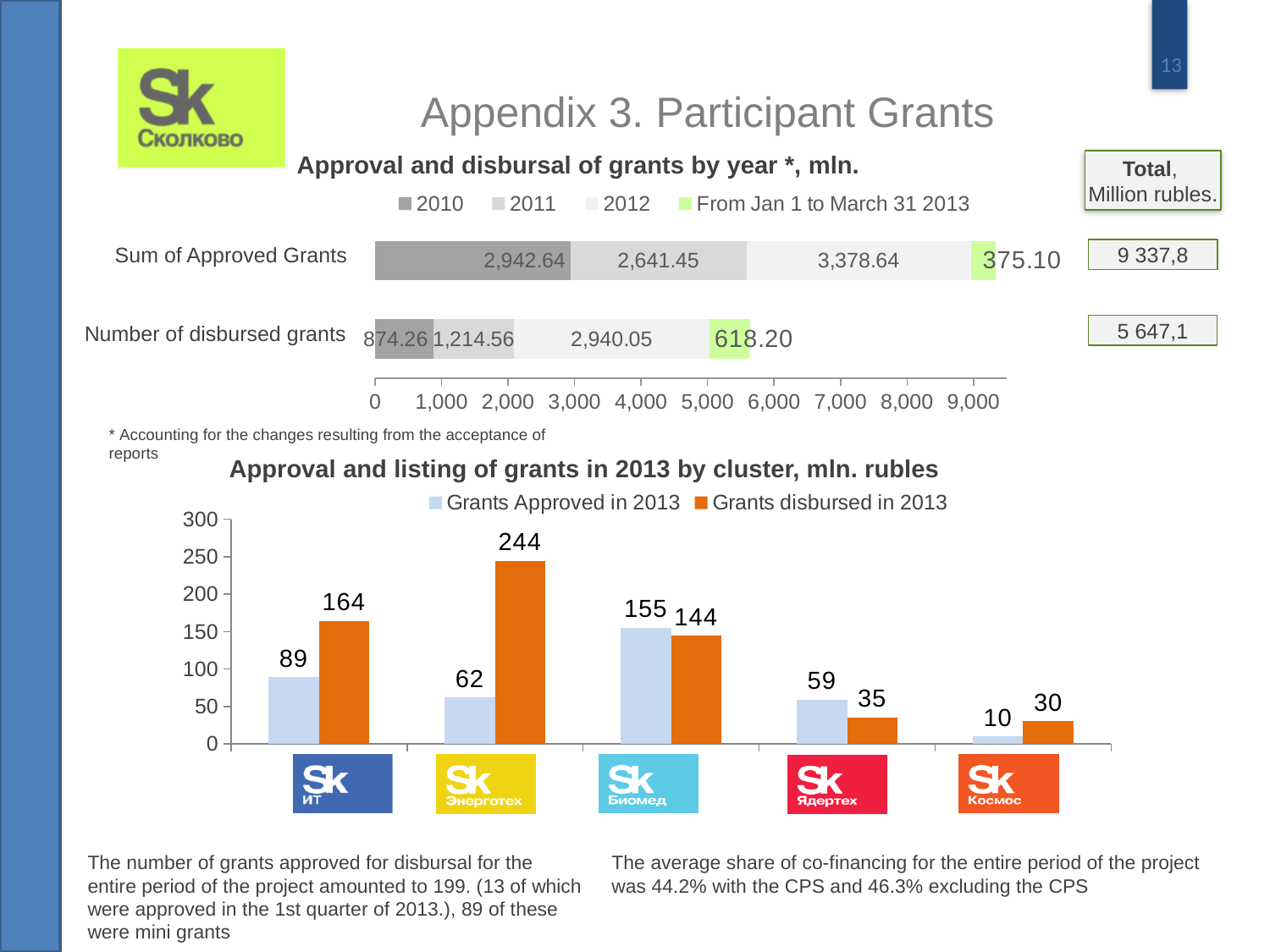
In the chart 'Approval and disbursal of grants by year', what is the difference between the 2010 and 2011 values for Sum of Approved Grants? 301.19 In the chart 'Approval and disbursal of grants by year', what is the 2010 value for Number of disbursed grants? 874.26 In the chart 'Approval and listing of grants in 2013 by cluster', how many clusters are shown on the x axis? 5 In the chart 'Approval and disbursal of grants by year', what is the 2012 value for Sum of Approved Grants? 3,378.64 What kind of chart is 'Approval and listing of grants in 2013 by cluster'? Bar chart In the chart 'Approval and disbursal of grants by year', what is the value for 'From Jan 1 to March 31 2013' for Sum of Approved Grants? 375.10 In the chart 'Approval and listing of grants in 2013 by cluster', what is the value of Grants disbursed in 2013 for the Энерготех cluster? 244 In the chart 'Approval and listing of grants in 2013 by cluster', which cluster has the lowest value of Grants disbursed in 2013? Космос In the chart 'Approval and listing of grants in 2013 by cluster', which cluster has the highest value of Grants Approved in 2013? Биомед In the chart 'Approval and disbursal of grants by year', which is larger for Number of disbursed grants: the 2011 value or the 2012 value? 2012 In the chart 'Approval and disbursal of grants by year', how many series does the legend list? 4 In the chart 'Approval and listing of grants in 2013 by cluster', what is the difference between Grants disbursed in 2013 and Grants Approved in 2013 for the ИТ cluster? 75